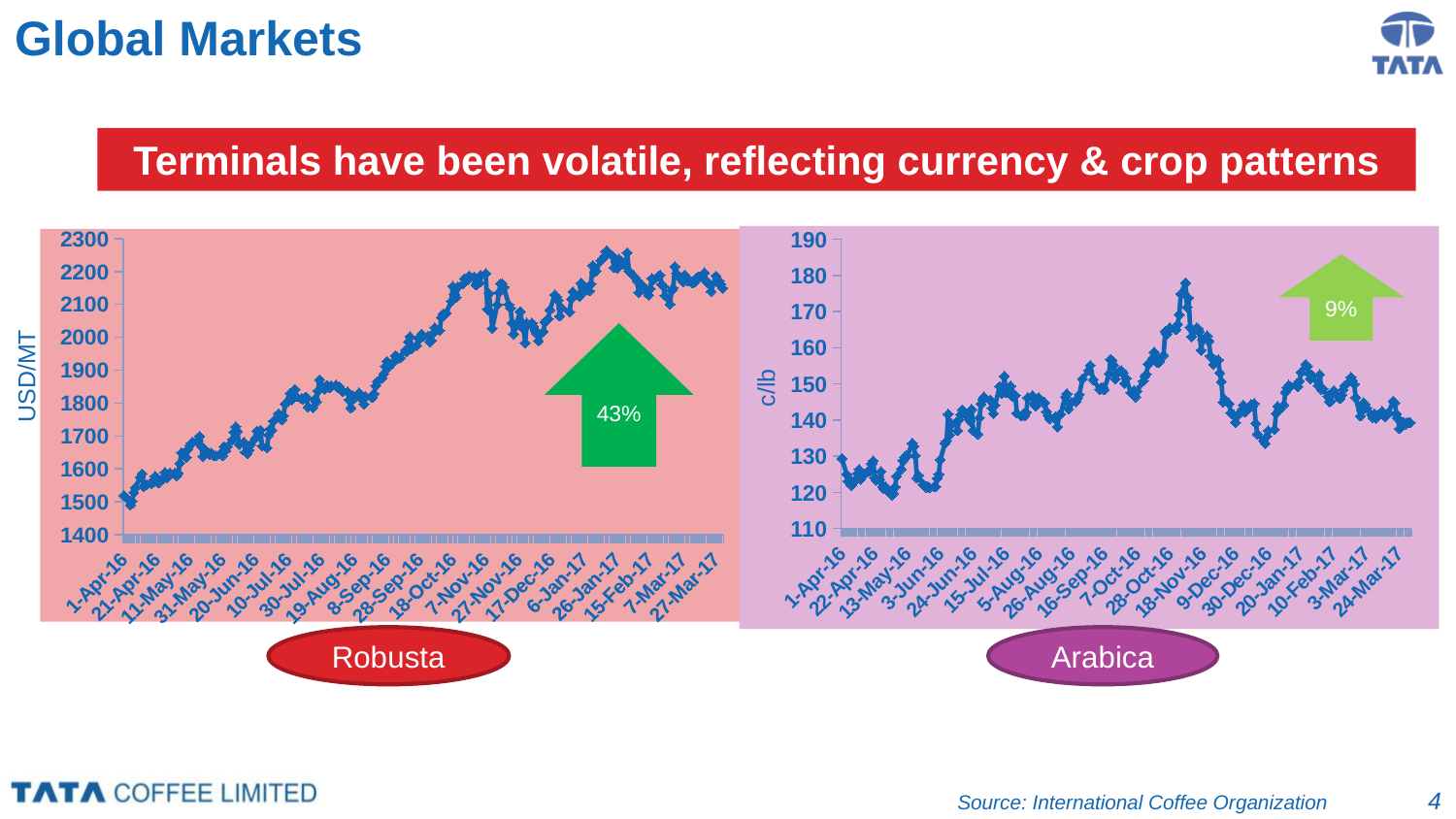
On the Robusta chart, is the value at 27-Mar-17 greater or less than 2000? greater On the Robusta chart, do the values overall rise or fall from 1-Apr-16 to 27-Mar-17? rise How many charts are shown on the slide? 2 On the Arabica chart, is the value at 24-Mar-17 greater or less than 150? less On the Robusta chart, what percentage is shown inside the green arrow? 43% What kind of chart is the Robusta chart on the left? line chart On the Arabica chart, is the highest point of the line greater or less than 190? less On the Arabica chart, do the values overall rise or fall from 1-Apr-16 to 24-Mar-17? rise On the Arabica chart, what percentage is shown inside the green arrow? 9%